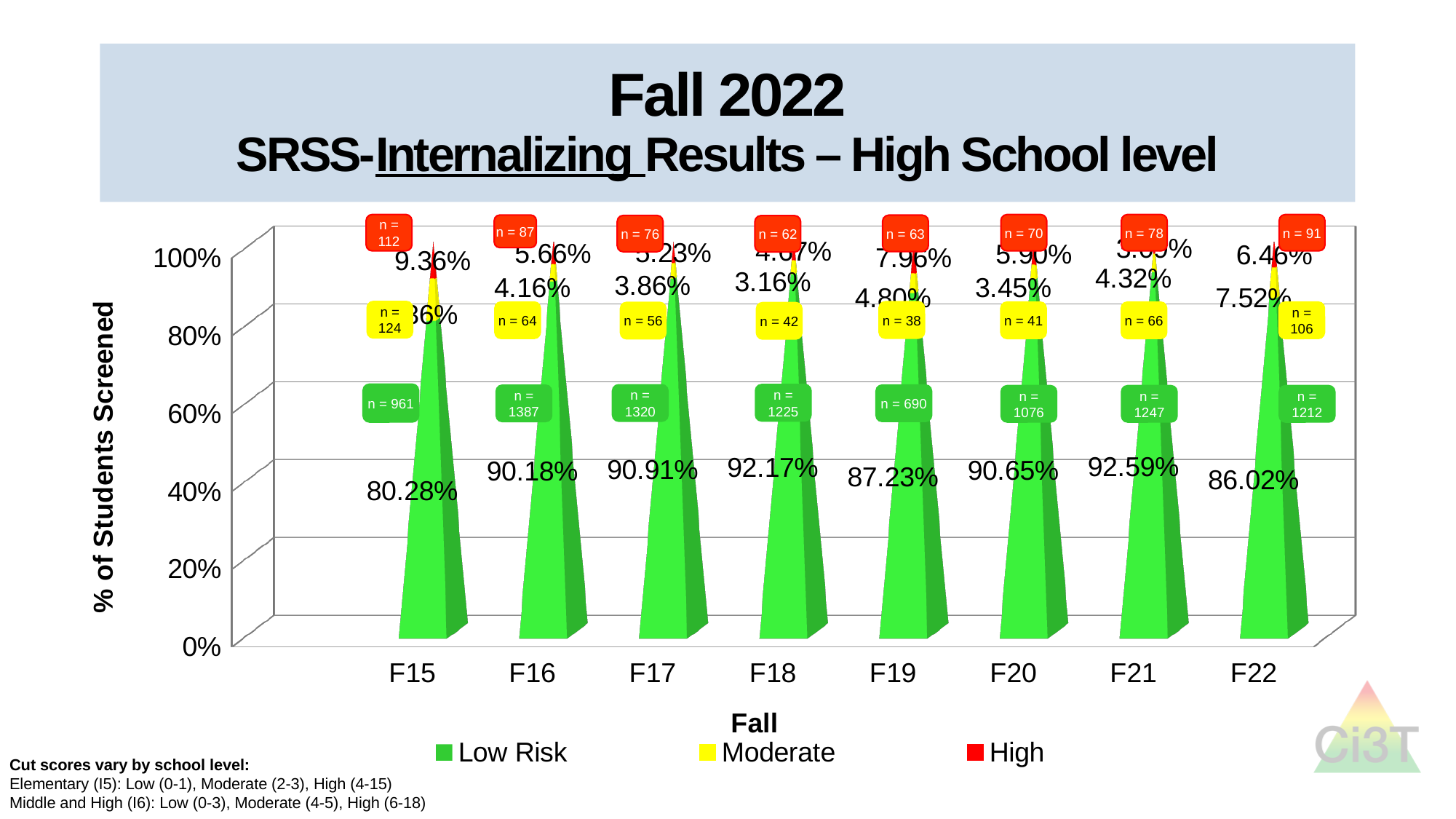
What is the title of the y axis? % of Students Screened What is the Low Risk percentage for F15? 80.28% Which has a larger Moderate percentage, F19 or F20? F19 What is the Low Risk percentage for F18? 92.17% Which fall term has the lowest Low Risk percentage? F15 What is the High percentage for F19? 7.96% How many fall terms are shown on the x axis? 8 What is the Moderate percentage for F22? 7.52% How many series does the legend list? 3 What is the difference between the Low Risk percentages for F17 and F16? 0.73 percentage points Which fall term has the highest Low Risk percentage? F21 Is the Low Risk value for F15 greater or less than 60%? greater